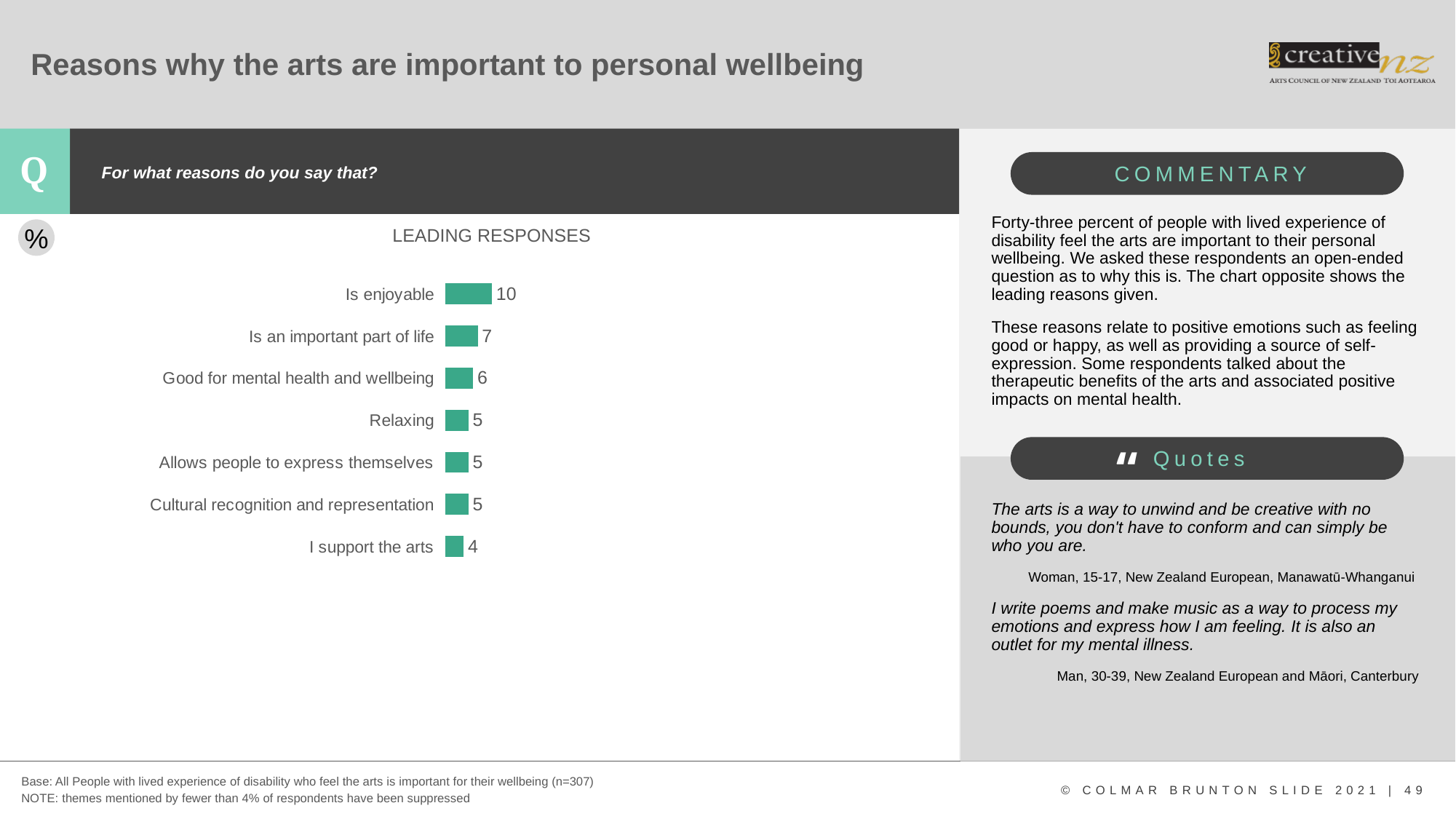
What is the value for "Is enjoyable"? 10 What is the difference between the values for "Is enjoyable" and "Relaxing"? 5 Which is larger, the value for "Is an important part of life" or the value for "Cultural recognition and representation"? Is an important part of life Which category has the lowest value? I support the arts How many categories have a value of 5? 3 What is the value for "I support the arts"? 4 How many categories are shown in the chart? 7 Which category has the highest value? Is enjoyable What kind of chart is shown on the slide? Bar chart What is the value for "Good for mental health and wellbeing"? 6 What is the value for "Is an important part of life"? 7 What is the title of the chart? LEADING RESPONSES